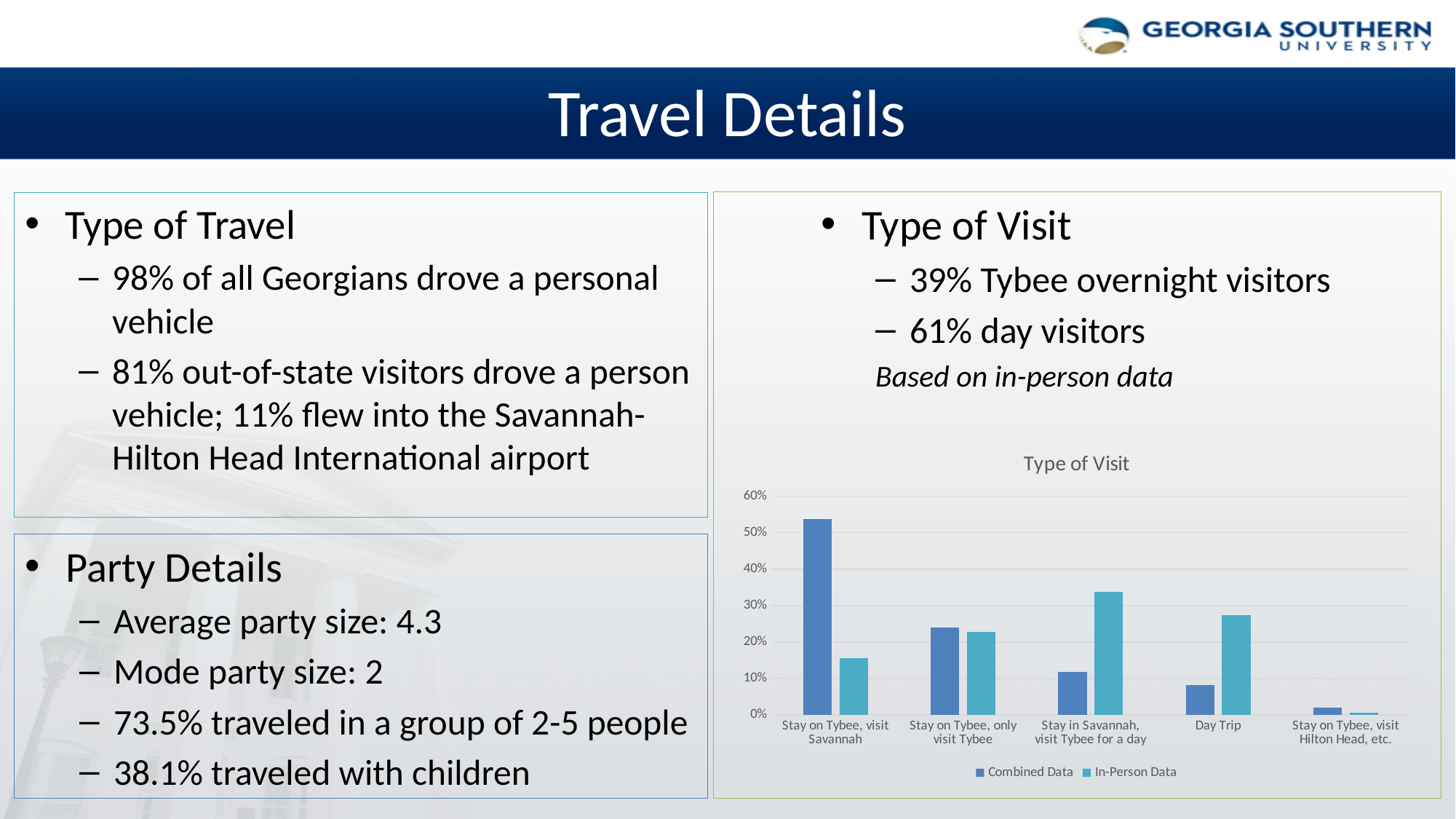
In the "Type of Visit" chart, is the Combined Data value for "Day Trip" greater or less than 10%? less In the "Type of Visit" chart, for "Stay in Savannah, visit Tybee for a day", which series has the larger value: Combined Data or In-Person Data? In-Person Data How many visit-type categories are shown on the x axis of the "Type of Visit" chart? 5 How many series does the legend of the "Type of Visit" chart list? 2 In the "Type of Visit" chart, is the In-Person Data value for "Day Trip" greater or less than 20%? greater What are the two series names listed in the legend of the "Type of Visit" chart? Combined Data and In-Person Data What kind of chart is the "Type of Visit" chart? bar chart In the "Type of Visit" chart, for "Stay on Tybee, visit Savannah", which series has the larger value: Combined Data or In-Person Data? Combined Data In the "Type of Visit" chart, which category has the highest Combined Data value? Stay on Tybee, visit Savannah In the "Type of Visit" chart, which category has the highest In-Person Data value? Stay in Savannah, visit Tybee for a day In the "Type of Visit" chart, which category has the lowest Combined Data value? Stay on Tybee, visit Hilton Head, etc. In the "Type of Visit" chart, is the Combined Data value for "Stay on Tybee, visit Savannah" greater or less than 50%? greater